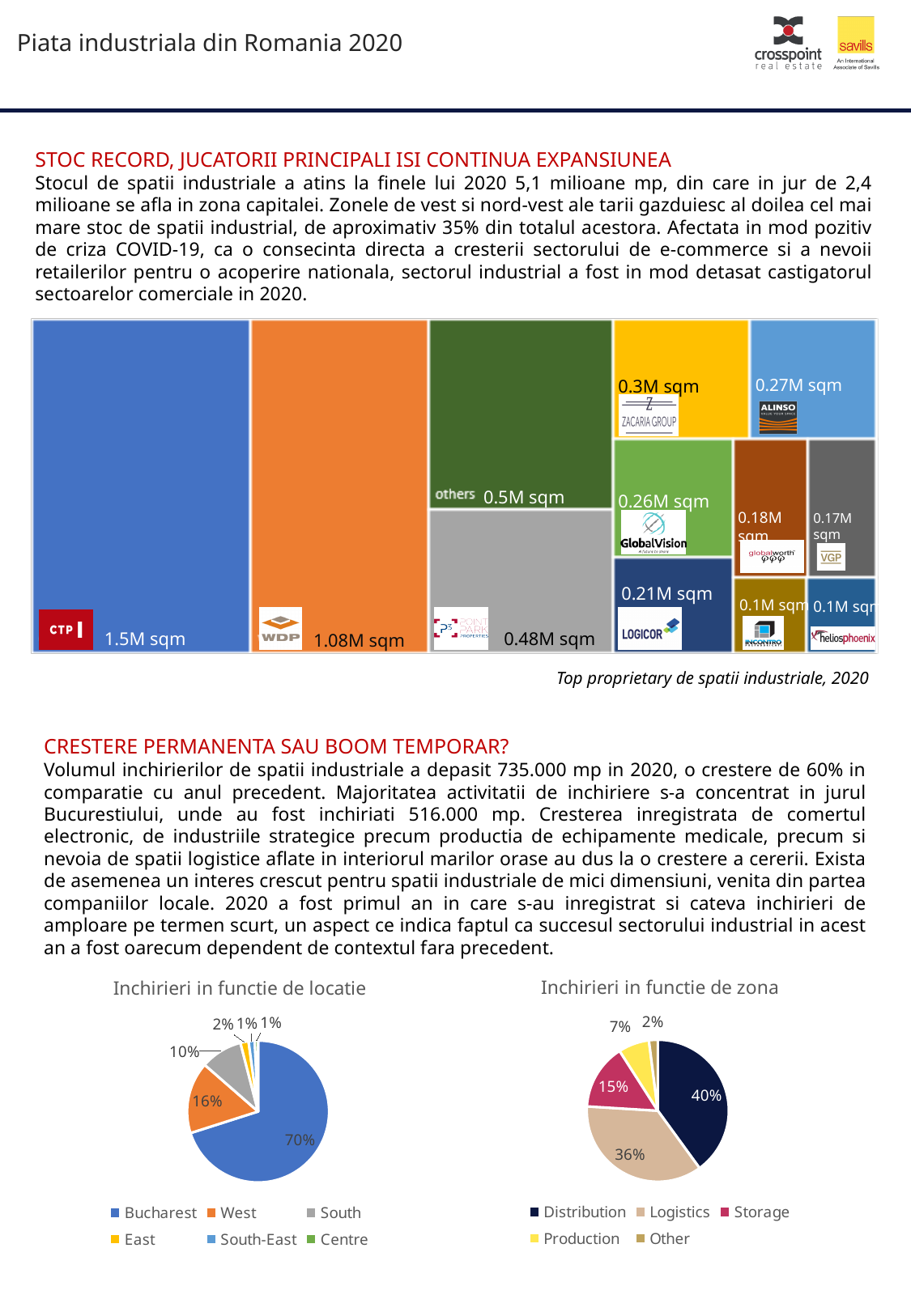
In the 'Top proprietary de spatii industriale, 2020' chart, what is the value shown for WDP? 1.08M sqm In the 'Inchirieri in functie de locatie' pie chart, what share does Bucharest have? 70% In the 'Inchirieri in functie de zona' pie chart, which is larger, Storage or Production? Storage In the 'Inchirieri in functie de locatie' pie chart, what share does West have? 16% In the 'Inchirieri in functie de locatie' pie chart, which category has the largest share? Bucharest In the 'Inchirieri in functie de locatie' pie chart, how many categories does the legend list? 6 In the 'Inchirieri in functie de zona' pie chart, which category has the smallest share? Other In the 'Inchirieri in functie de zona' pie chart, what is the difference in percentage points between Distribution and Logistics? 4 percentage points In the 'Top proprietary de spatii industriale, 2020' chart, what is the value shown for CTP? 1.5M sqm In the 'Inchirieri in functie de zona' pie chart, what share does Distribution have? 40% In the 'Inchirieri in functie de zona' pie chart, what share does Storage have? 15% What kind of chart is 'Inchirieri in functie de zona'? Pie chart